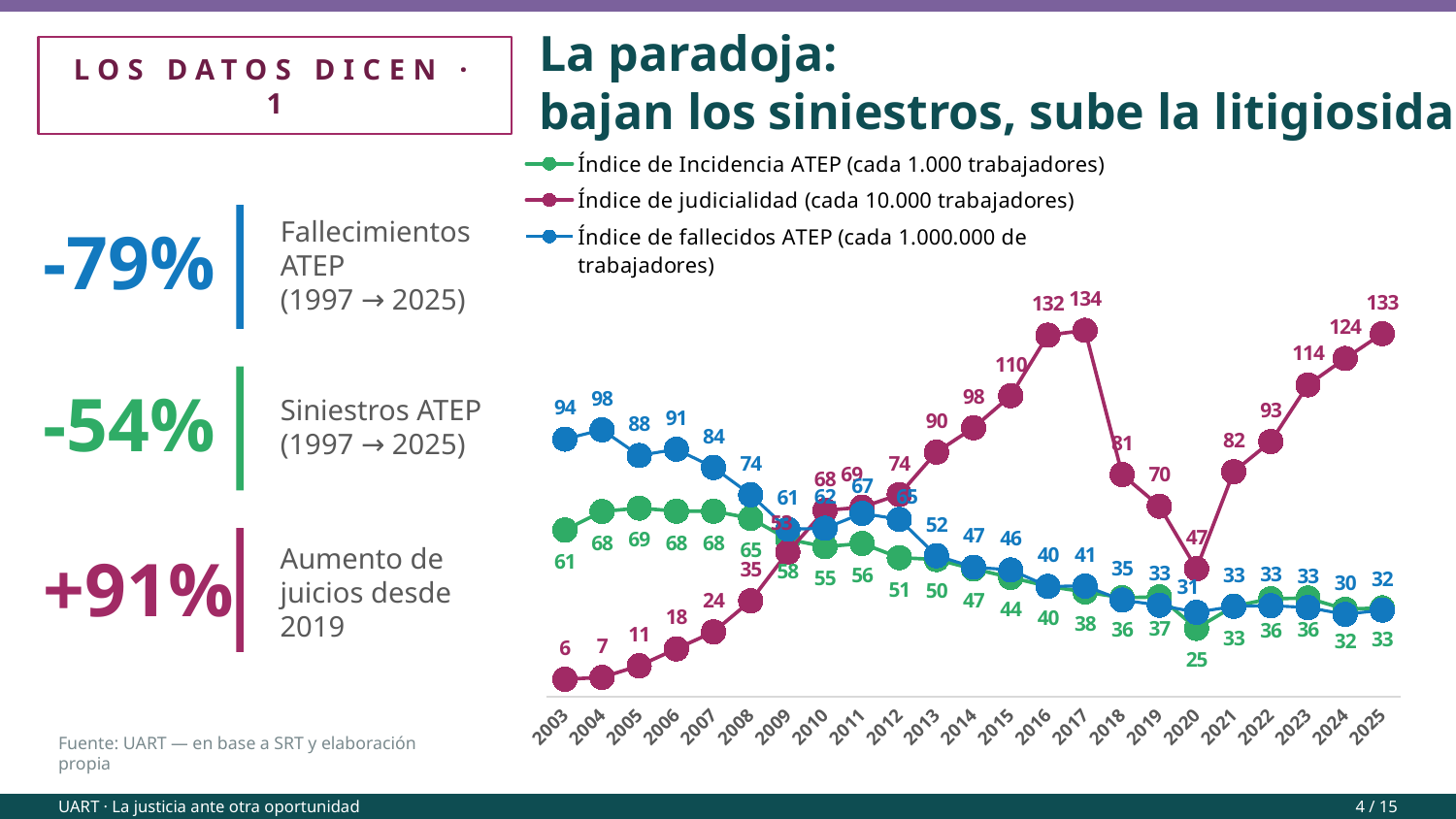
Does the Índice de fallecidos ATEP generally rise or fall from 2003 to 2025? fall In which year does the Índice de judicialidad reach its highest value? 2017 How many years are plotted along the x axis of the chart? 23 What is the title of the chart's slide? La paradoja: bajan los siniestros, sube la litigiosidad What is the value of the Índice de Incidencia ATEP in 2020? 25 How many series does the chart legend list? 3 What kind of chart is shown on the slide? line chart What is the difference between the Índice de judicialidad in 2017 and in 2018? 53 What is the value of the Índice de judicialidad in 2025? 133 What is the lowest value of the Índice de judicialidad series? 6 Which is larger in 2013: the Índice de judicialidad or the Índice de fallecidos ATEP? Índice de judicialidad What is the value of the Índice de fallecidos ATEP in 2004? 98